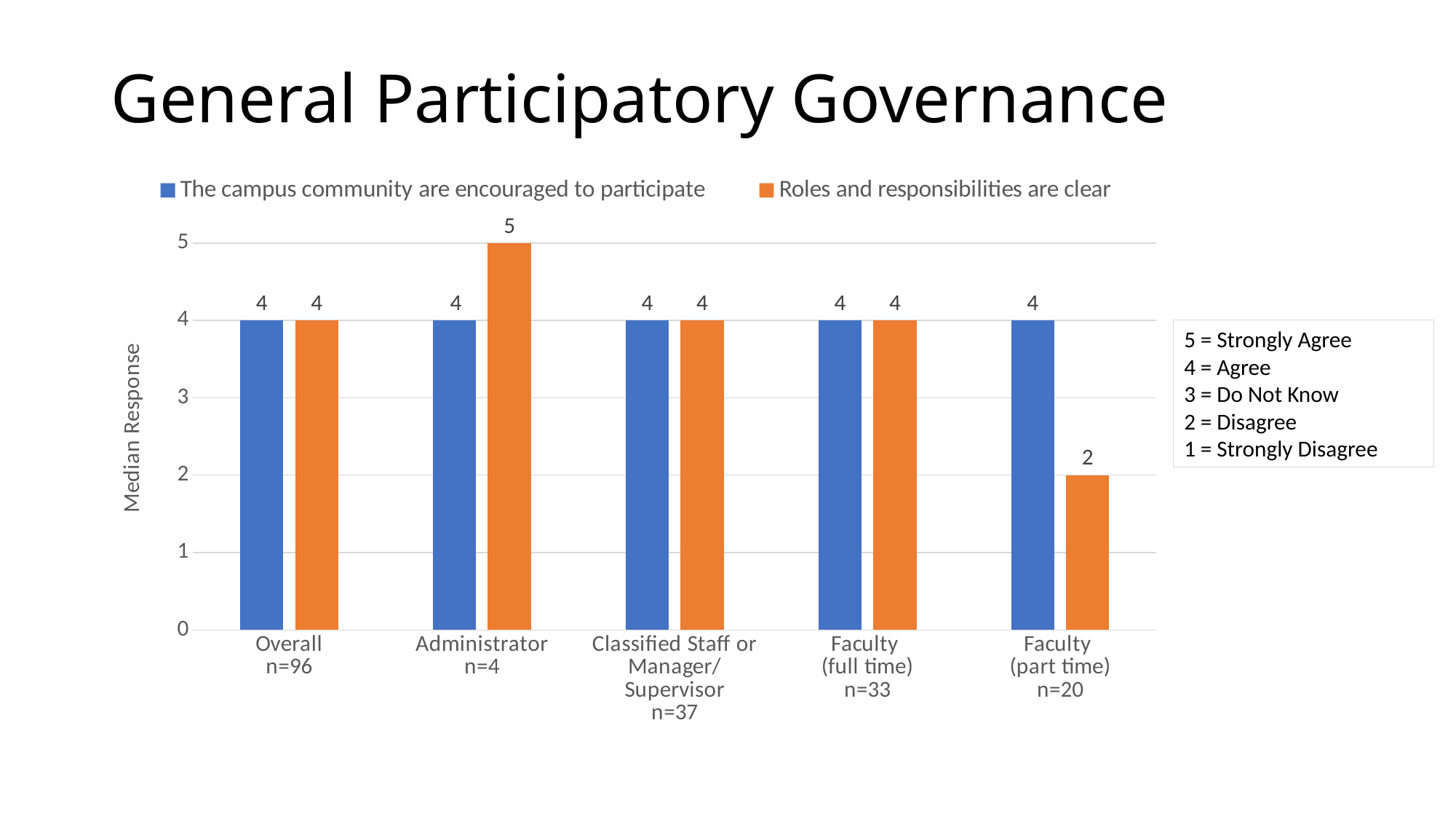
What is the label of the vertical axis? Median Response What is the median response for 'The campus community are encouraged to participate' in the Overall group? 4 Which group has the highest median response for 'Roles and responsibilities are clear'? Administrator Which group has the lowest median response for 'Roles and responsibilities are clear'? Faculty (part time) How many series does the legend list? 2 What is the median response for 'Roles and responsibilities are clear' among Administrators? 5 How many groups are shown on the x axis? 5 What is the median response for 'Roles and responsibilities are clear' among part-time Faculty? 2 For part-time Faculty, which series has the larger median response? The campus community are encouraged to participate What is the difference between the two series' median responses for Administrators? 1 What is the difference between the two series' median responses for part-time Faculty? 2 What kind of chart is shown on the slide? Bar chart